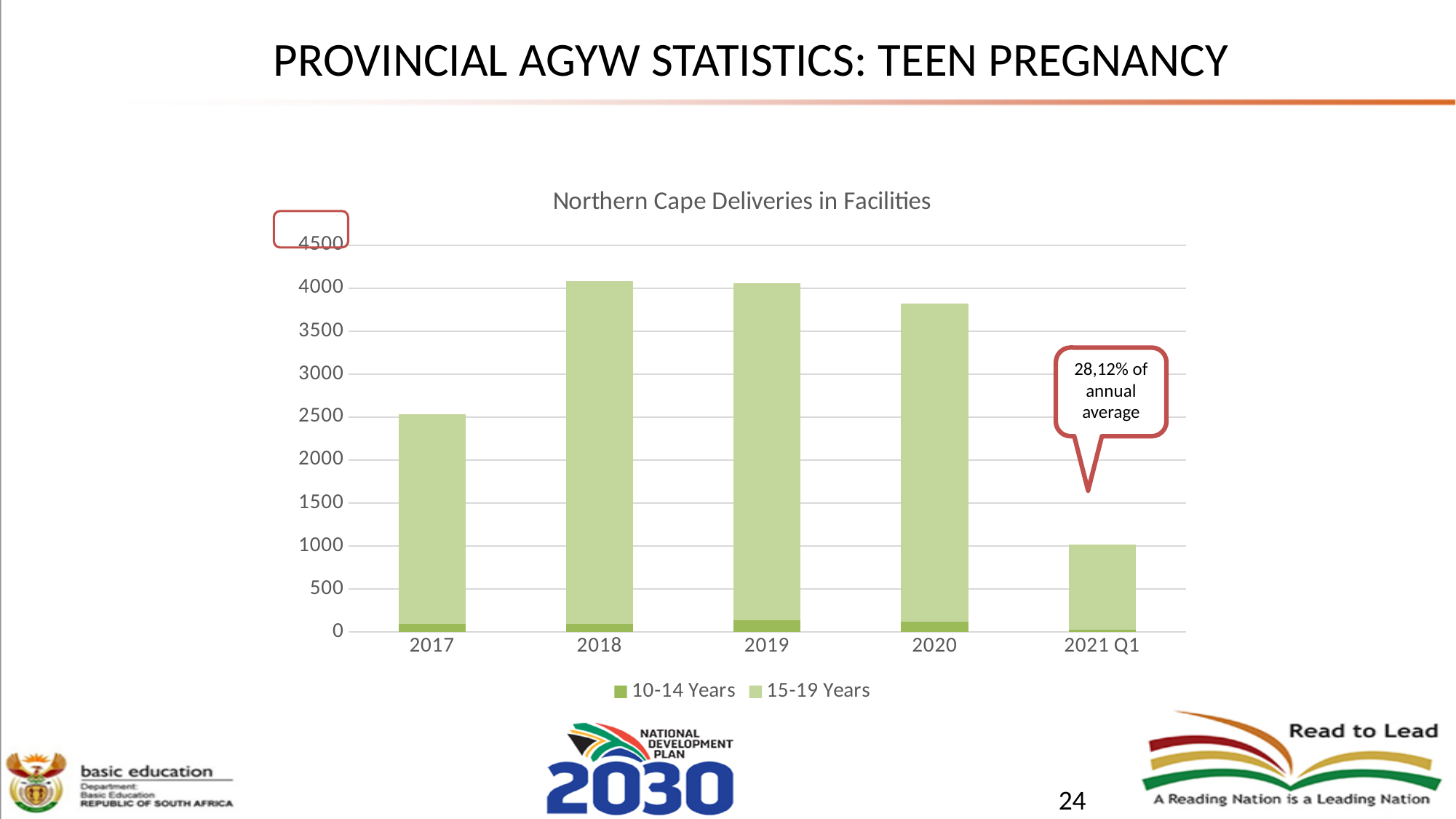
Is the total value for 2021 Q1 greater or less than 1500? less What kind of chart is shown on the slide? bar chart Which has the larger total bar, 2017 or 2020? 2020 Which category has the lowest total bar in the chart? 2021 Q1 Which series are listed in the chart's legend? 10-14 Years and 15-19 Years Is the total value for 2017 greater or less than 3000? less What is the title of the chart? Northern Cape Deliveries in Facilities Is the total value for 2017 greater or less than 2000? greater How many categories are shown on the x axis of the chart? 5 How many series does the chart's legend list? 2